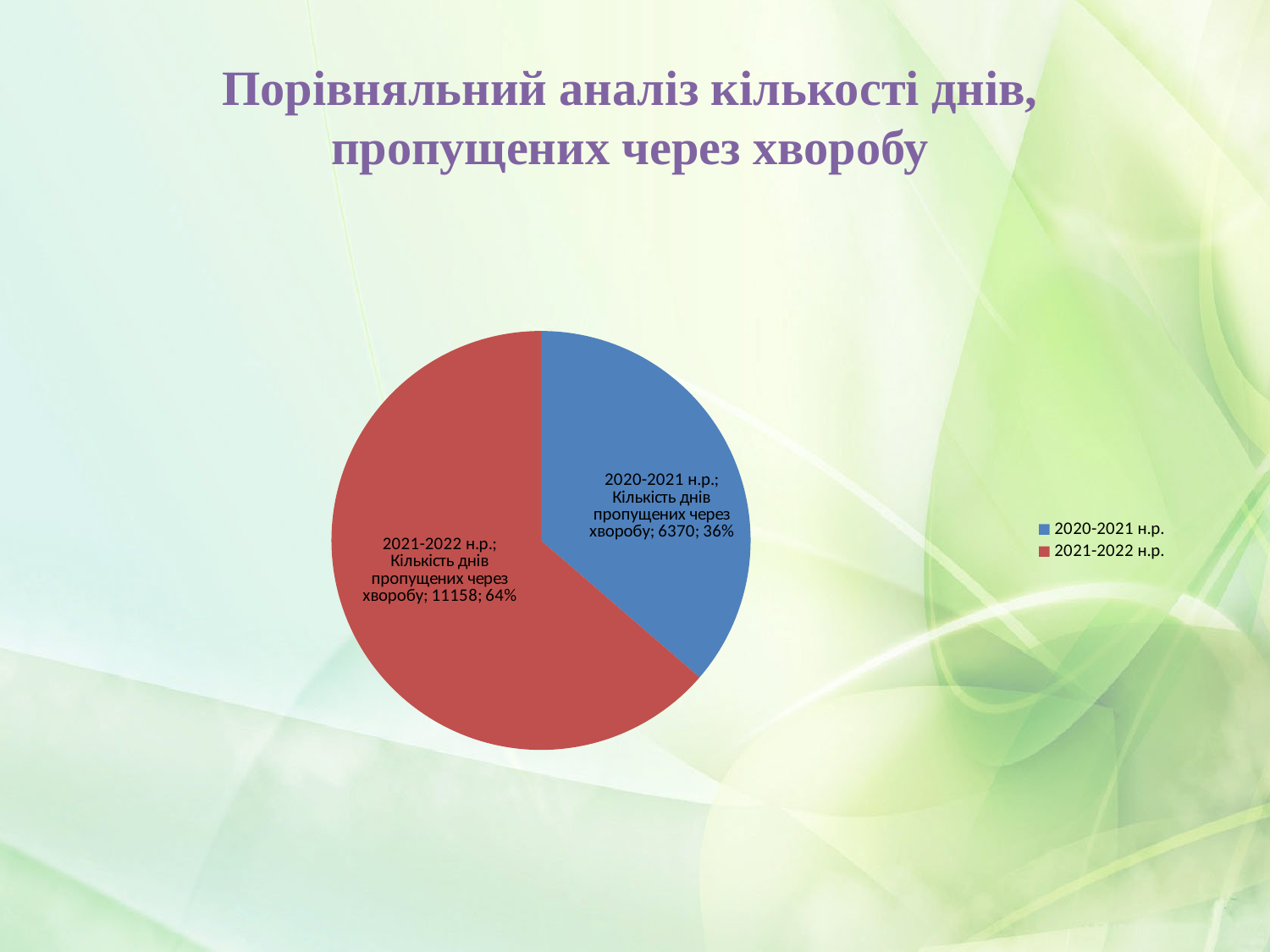
Which colour represents 2021-2022 н.р. in the pie chart? red What is the number of days missed due to illness for 2020-2021 н.р.? 6370 What kind of chart is shown on the slide? pie chart What is the difference in days missed between 2021-2022 н.р. and 2020-2021 н.р.? 4788 What share of the pie does the 2021-2022 н.р. slice represent? 64% What is the total number of days missed across both school years? 17528 How many entries does the legend list? 2 What share of the pie does the 2020-2021 н.р. slice represent? 36% What is the number of days missed due to illness for 2021-2022 н.р.? 11158 Which school year has the larger number of days missed due to illness? 2021-2022 н.р. Which school year has the smaller number of days missed due to illness? 2020-2021 н.р. How many slices does the pie chart have? 2